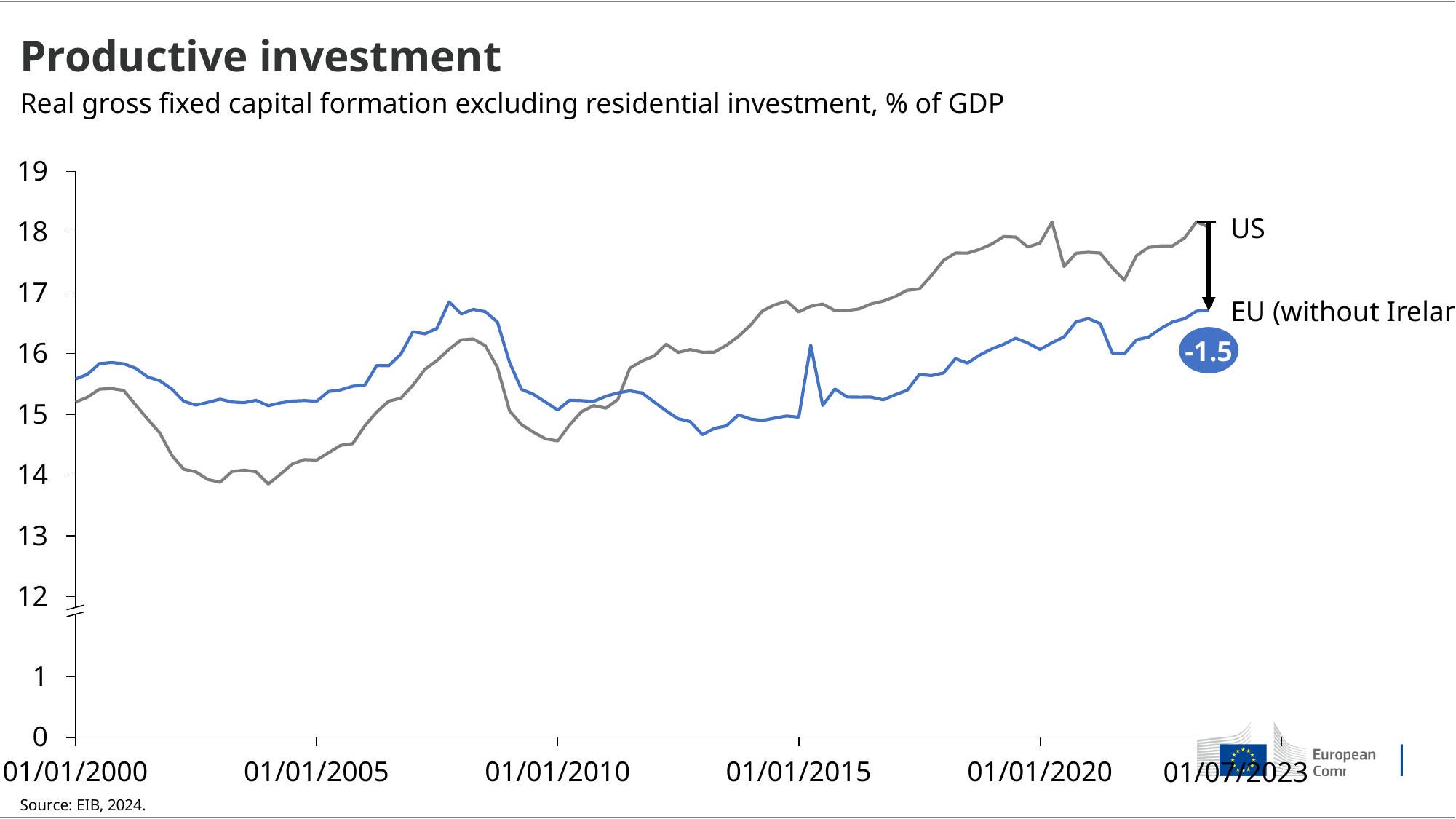
Does the US series generally rise or fall between 01/01/2010 and 01/01/2020? rise Is the value for EU (without Ireland) at 01/01/2000 greater or less than 15? greater Is the value for US at 01/01/2010 greater or less than 15? less What gap between the US and EU (without Ireland) series is annotated at the end of the chart? -1.5 Is the value for US at 01/01/2005 greater or less than 15? less What source is cited for the chart? EIB, 2024 What is the title of the chart? Productive investment Which series is higher at 01/01/2005, US or EU (without Ireland)? EU (without Ireland) What kind of chart is shown on the slide? line chart Which series is higher at the end of the chart (01/07/2023), US or EU (without Ireland)? US How many series are plotted on the chart? 2